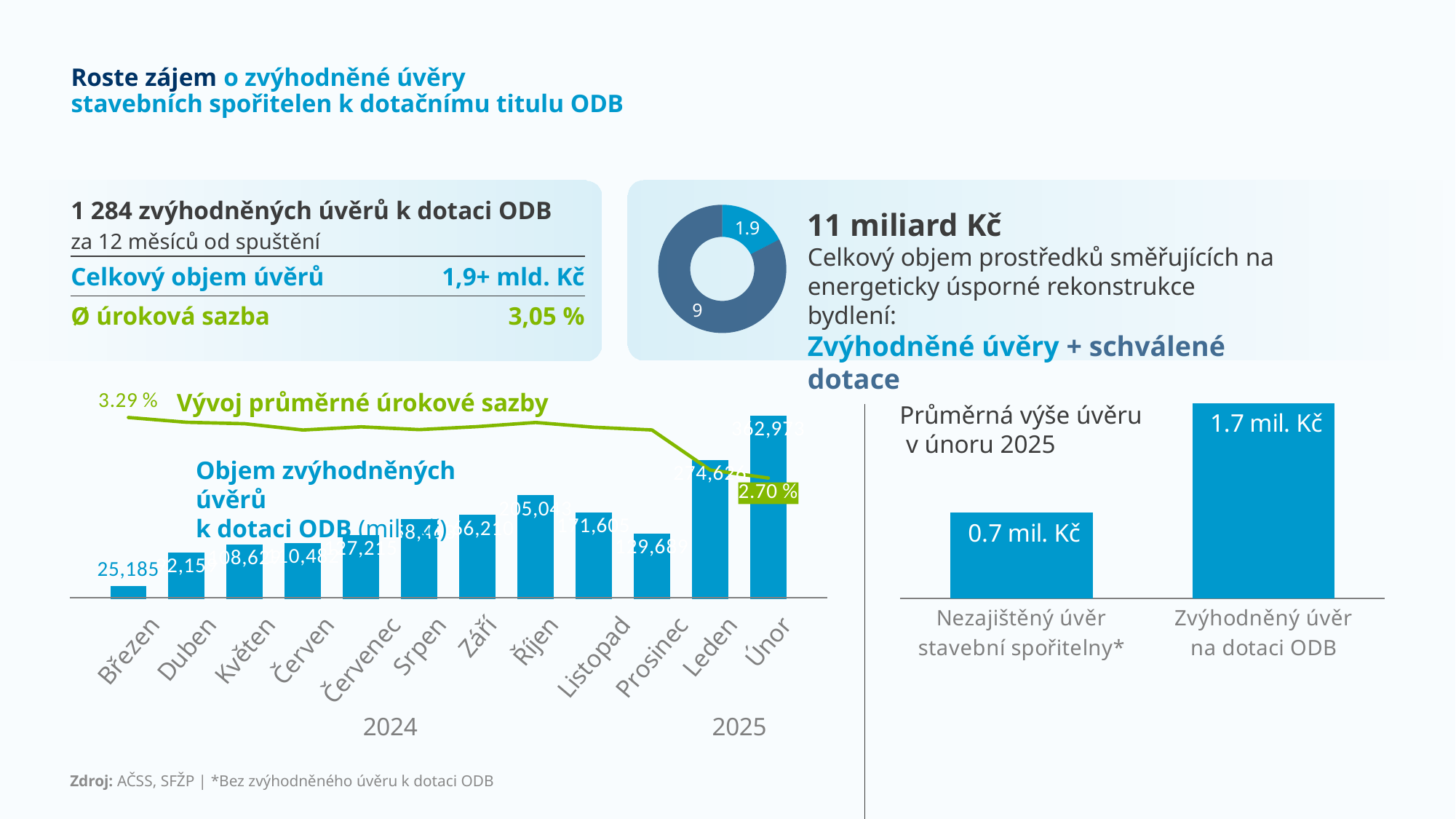
In the line 'Vývoj průměrné úrokové sazby', what is the value at the end of the line (Únor)? 2.70 % In the chart 'Průměrná výše úvěru v únoru 2025', what is the difference between the two bars? 1.0 mil. Kč In the chart 'Průměrná výše úvěru v únoru 2025', what is the value for 'Nezajištěný úvěr stavební spořitelny*'? 0.7 mil. Kč In the donut chart next to '11 miliard Kč', which of the two slices is larger, 1.9 or 9? 9 In the chart 'Objem zvýhodněných úvěrů k dotaci ODB', which month has the lowest bar? Březen In the chart 'Objem zvýhodněných úvěrů k dotaci ODB', which month has the highest bar? Únor In the chart 'Průměrná výše úvěru v únoru 2025', what is the value for 'Zvýhodněný úvěr na dotaci ODB'? 1.7 mil. Kč In the line 'Vývoj průměrné úrokové sazby', what is the value at the start of the line? 3.29 % Does the line 'Vývoj průměrné úrokové sazby' rise or fall from Březen to Únor? fall In the chart 'Objem zvýhodněných úvěrů k dotaci ODB', what is the value for Březen? 25,185 In the chart 'Průměrná výše úvěru v únoru 2025', which bar is higher? Zvýhodněný úvěr na dotaci ODB How many months are shown on the x axis of the chart 'Objem zvýhodněných úvěrů k dotaci ODB'? 12